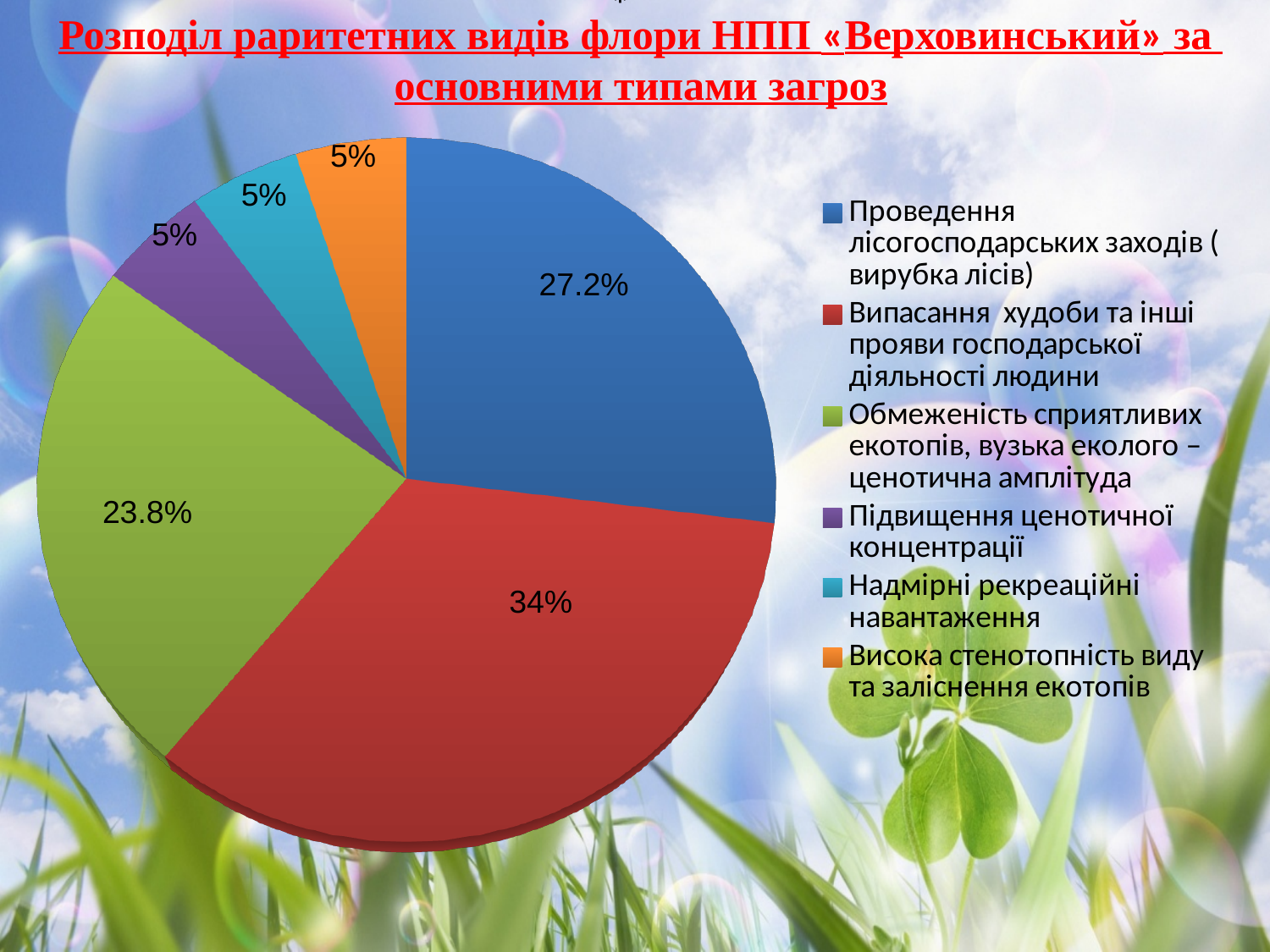
What colour is the slice for "Висока стенотопність виду та залісення екотопів"? orange What is the title of the chart on the slide? Розподіл раритетних видів флори НПП «Верховинський» за основними типами загроз What is the value shown for "Обмеженість сприятливих екотопів, вузька еколого – ценотична амплітуда"? 23.8% What is the value shown for "Проведення лісогосподарських заходів (вирубка лісів)"? 27.2% What share of the pie does "Випасання худоби та інші прояви господарської діяльності людини" take? 34% What kind of chart is shown on the slide? pie chart What is the value shown for "Надмірні рекреаційні навантаження"? 5% How many slices does the pie chart have? 6 How many entries does the legend list? 6 Which is larger: the slice for "Проведення лісогосподарських заходів (вирубка лісів)" or the slice for "Обмеженість сприятливих екотопів, вузька еколого – ценотична амплітуда"? Проведення лісогосподарських заходів (вирубка лісів) Which category has the largest slice of the pie? Випасання худоби та інші прояви господарської діяльності людини What is the difference between the values for "Випасання худоби та інші прояви господарської діяльності людини" and "Проведення лісогосподарських заходів (вирубка лісів)"? 6.8%